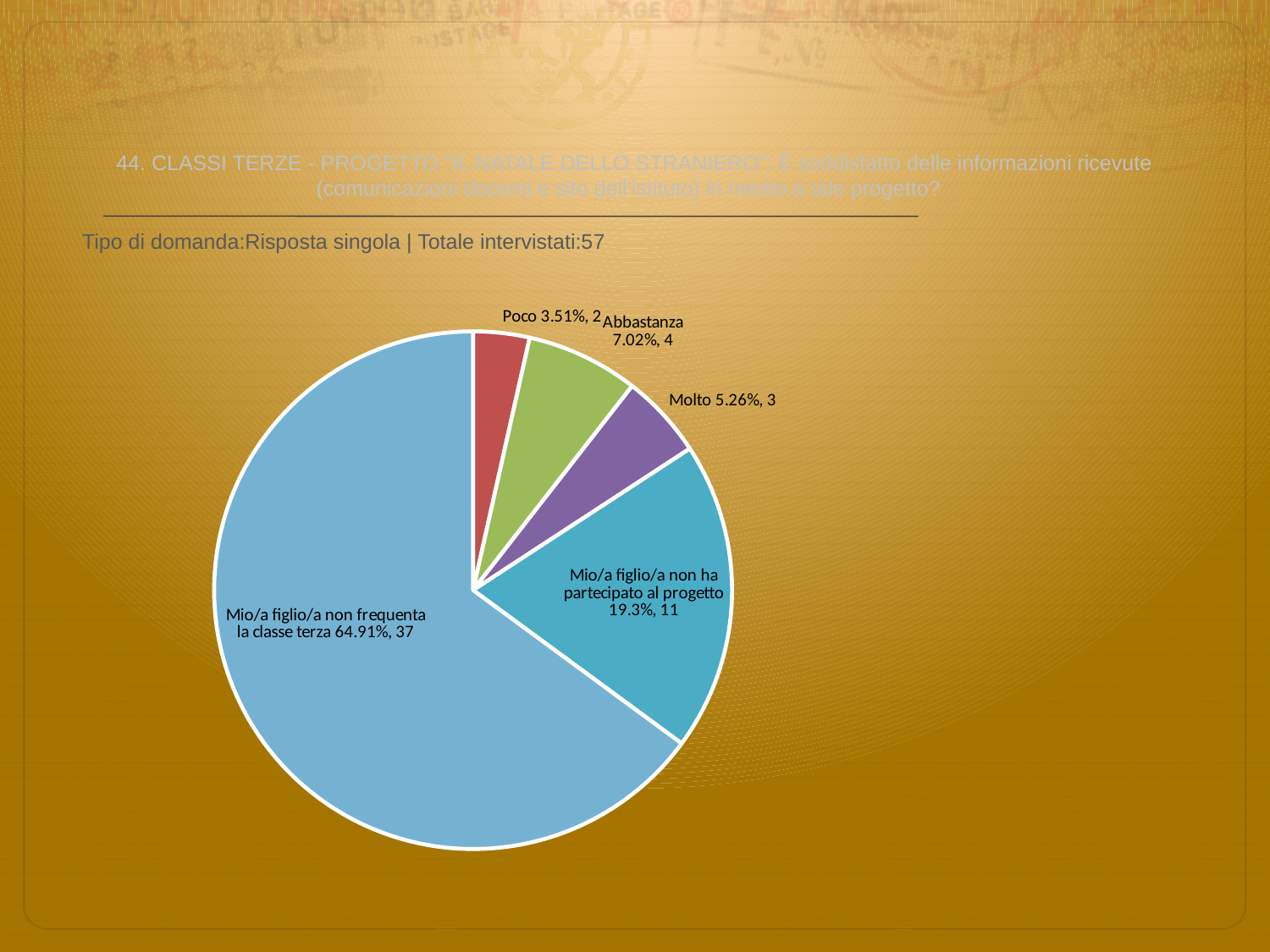
What is the difference in count between "Mio/a figlio/a non frequenta la classe terza" and "Mio/a figlio/a non ha partecipato al progetto"? 26 What is the count for "Abbastanza"? 4 What colour is the "Poco" slice? red What percentage share does the slice "Mio/a figlio/a non frequenta la classe terza" have? 64.91% What is the total number of respondents (Totale intervistati) stated on the slide? 57 What percentage share does the "Molto" slice have? 5.26% Which category has the smallest slice? Poco How many slices does the pie chart have? 5 Which is larger, the count for "Abbastanza" or the count for "Molto"? Abbastanza How many respondents chose "Mio/a figlio/a non ha partecipato al progetto"? 11 Which category has the largest slice? Mio/a figlio/a non frequenta la classe terza What kind of chart is shown on the slide? pie chart